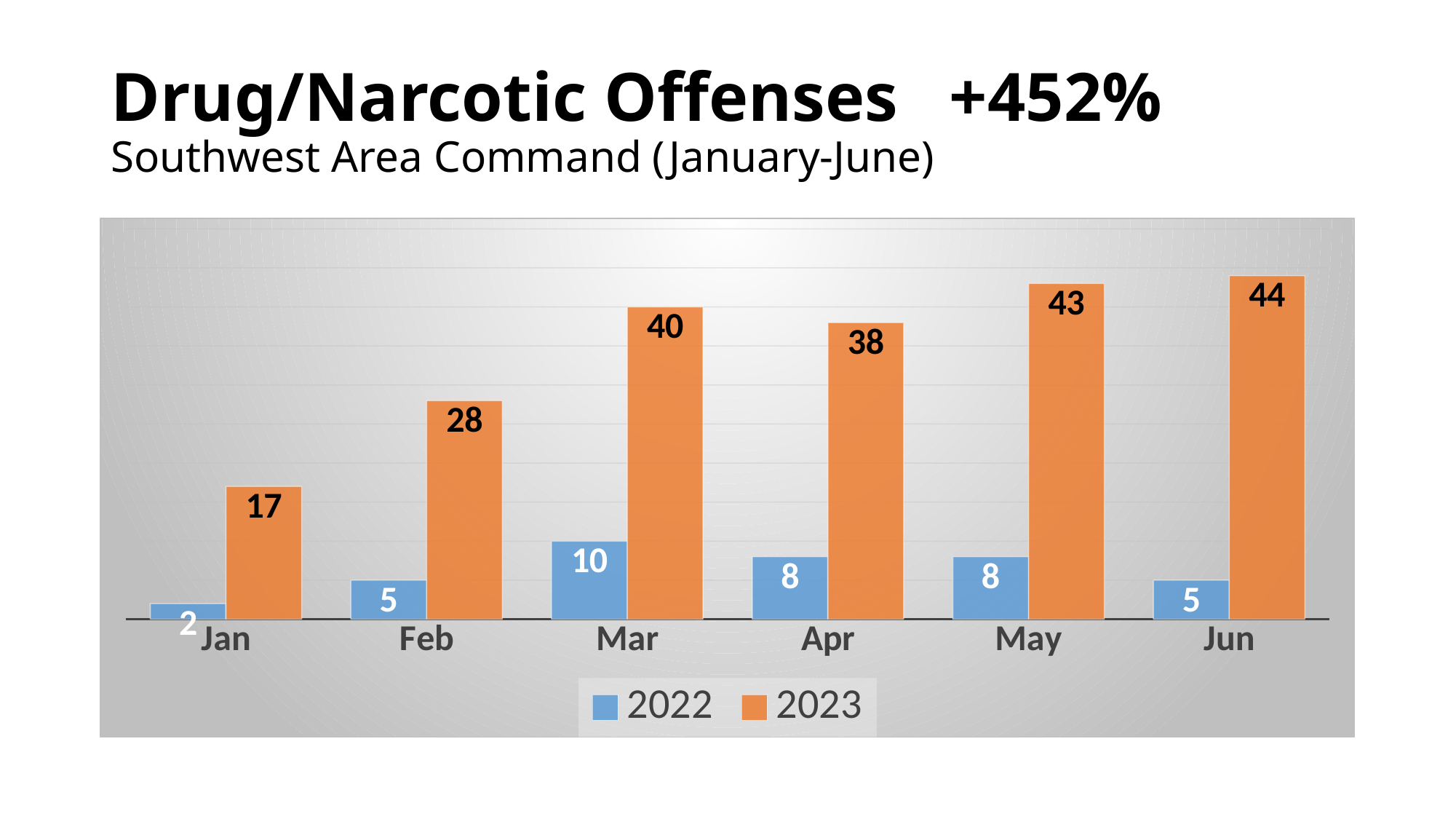
How many series does the legend list? 2 What is the difference between the 2023 and 2022 values for May? 35 Which is larger, the 2023 value for Mar or the 2023 value for Apr? Mar What percentage change is shown in the slide title? +452% What kind of chart is shown on the slide? Bar chart What is the 2023 value for Jan? 17 Do the 2023 values generally rise or fall from Jan to Jun? Rise What is the 2023 value for Mar? 40 What is the 2022 value for Feb? 5 Which month has the lowest 2022 value? Jan Which month has the highest 2023 value? Jun How many months are shown on the x axis? 6